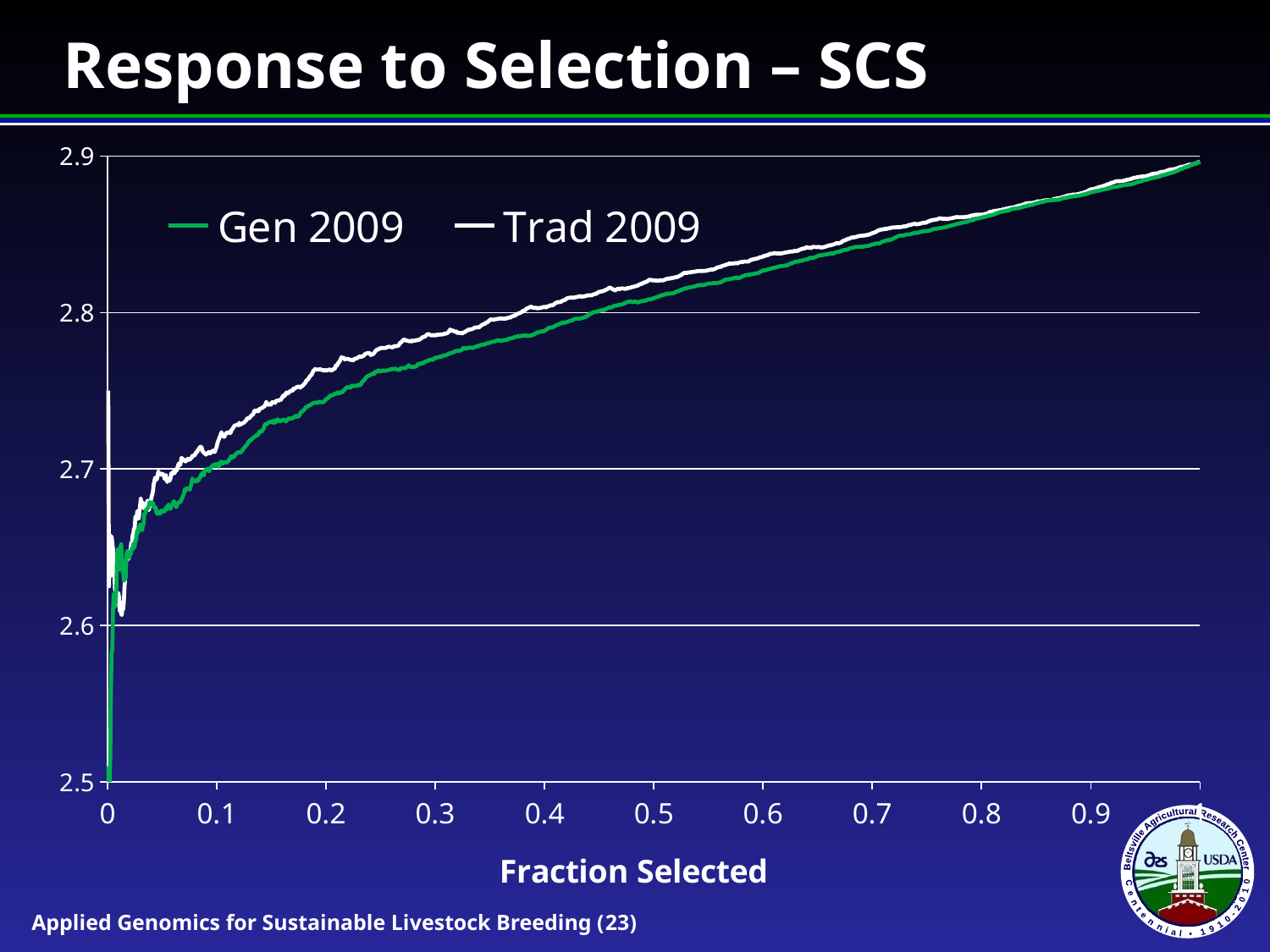
What kind of chart is shown on the slide? line chart Is the value of Gen 2009 at a Fraction Selected of 0.5 greater or less than 2.8? greater At a Fraction Selected of 0.5, which series has the higher value, Gen 2009 or Trad 2009? Trad 2009 Do the values of the Gen 2009 line rise or fall as Fraction Selected increases from 0.1 to 0.9? rise Is the value of Gen 2009 at a Fraction Selected of 0.3 greater or less than 2.8? less How many series does the legend list? 2 What is the label of the x axis? Fraction Selected What are the two series named in the legend? Gen 2009 and Trad 2009 Is the value of Trad 2009 at a Fraction Selected of 0.9 greater or less than 2.9? less At a Fraction Selected of 0.3, which series has the higher value, Gen 2009 or Trad 2009? Trad 2009 Do the values of the Trad 2009 line rise or fall as Fraction Selected increases from 0.1 to 0.9? rise